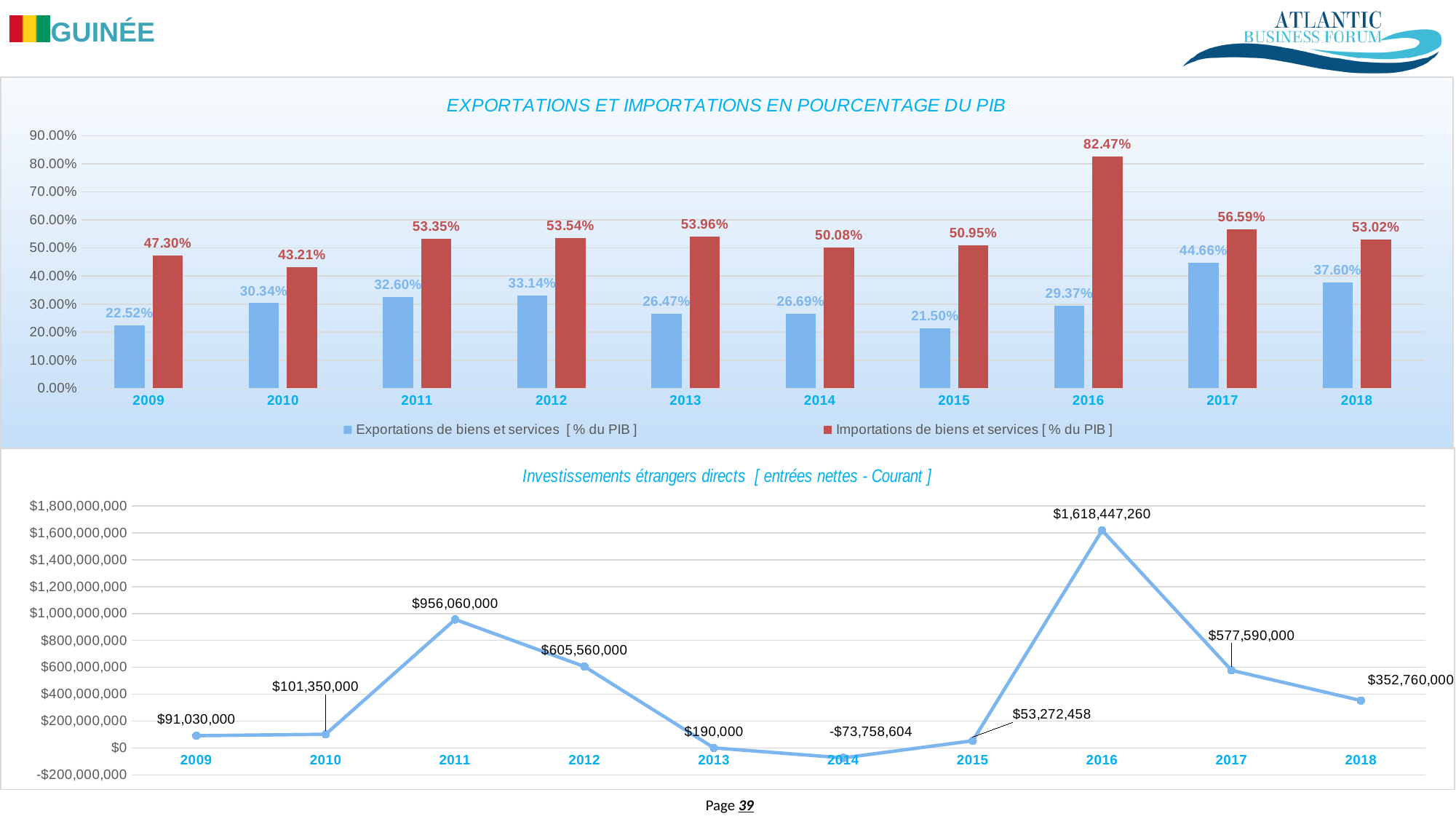
In the chart 'EXPORTATIONS ET IMPORTATIONS EN POURCENTAGE DU PIB', what is the difference between Importations and Exportations in 2009? 24.78% In the chart 'Investissements étrangers directs', which year has the lowest value? 2014 In the chart 'Investissements étrangers directs', do the values rise or fall from 2016 to 2018? Fall In the chart 'EXPORTATIONS ET IMPORTATIONS EN POURCENTAGE DU PIB', which year has the lowest value for Exportations de biens et services? 2015 In the chart 'Investissements étrangers directs', which is larger, the value for 2011 or the value for 2012? 2011 What kind of chart is 'EXPORTATIONS ET IMPORTATIONS EN POURCENTAGE DU PIB'? Bar chart What kind of chart is 'Investissements étrangers directs'? Line chart In the chart 'EXPORTATIONS ET IMPORTATIONS EN POURCENTAGE DU PIB', what is the value of Importations de biens et services for 2016? 82.47% In the chart 'EXPORTATIONS ET IMPORTATIONS EN POURCENTAGE DU PIB', how many series does the legend list? 2 In the chart 'EXPORTATIONS ET IMPORTATIONS EN POURCENTAGE DU PIB', how many years are shown on the x axis? 10 In the chart 'Investissements étrangers directs', what is the value for 2016? $1,618,447,260 In the chart 'EXPORTATIONS ET IMPORTATIONS EN POURCENTAGE DU PIB', what is the value of Exportations de biens et services for 2017? 44.66%